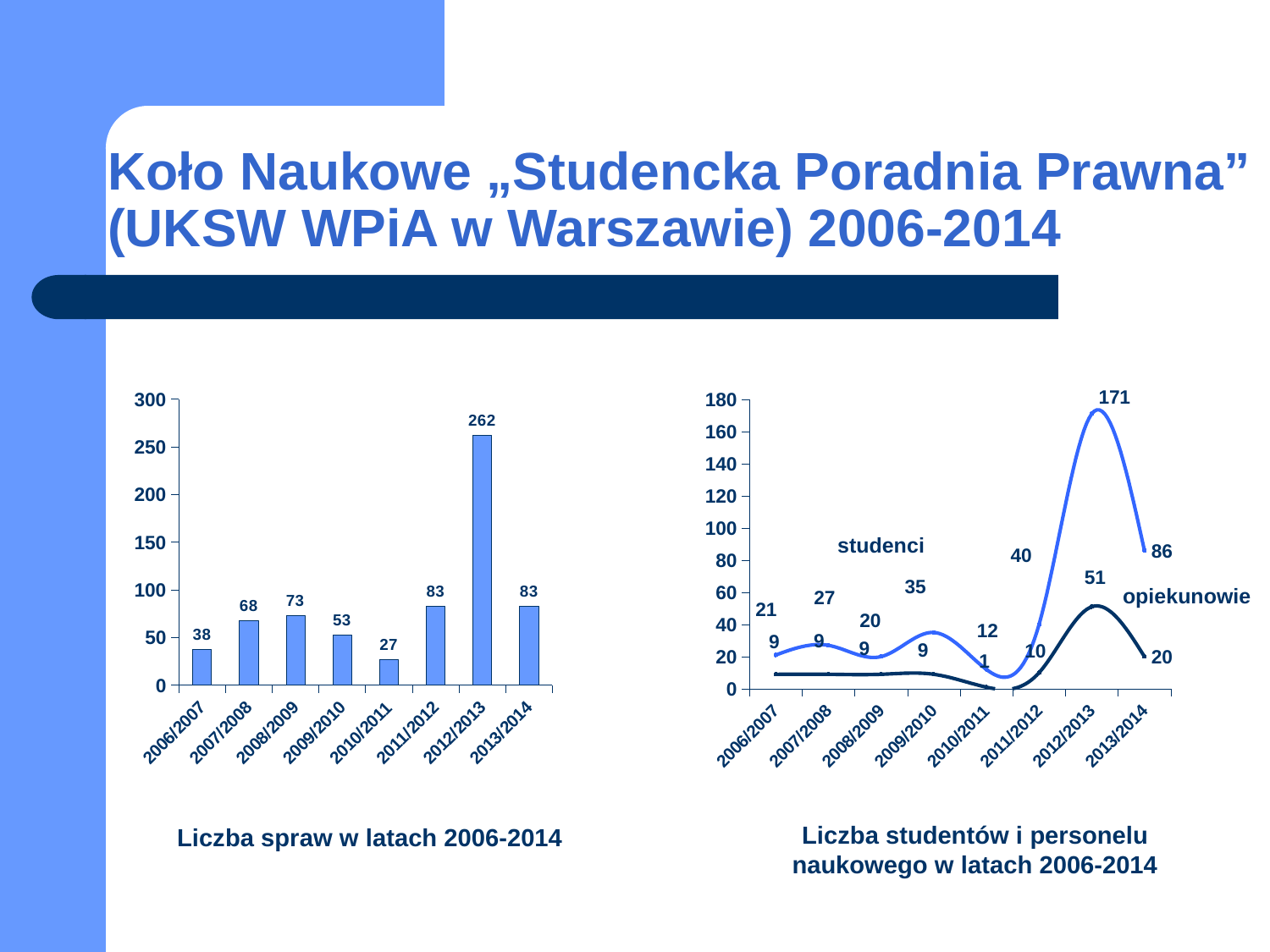
In the chart 'Liczba spraw w latach 2006-2014', what is the difference between the values for 2012/2013 and 2013/2014? 179 In the chart 'Liczba spraw w latach 2006-2014', which is larger, the value for 2007/2008 or 2009/2010? 2007/2008 In the chart 'Liczba studentów i personelu naukowego w latach 2006-2014', what is the value for opiekunowie in 2010/2011? 1 In the chart 'Liczba studentów i personelu naukowego w latach 2006-2014', what is the difference between studenci and opiekunowie in 2013/2014? 66 In the chart 'Liczba studentów i personelu naukowego w latach 2006-2014', what is the value for studenci in 2012/2013? 171 In the chart 'Liczba studentów i personelu naukowego w latach 2006-2014', what are the names of the two series labelled on the chart? studenci and opiekunowie What kind of chart is 'Liczba spraw w latach 2006-2014'? bar chart In the chart 'Liczba spraw w latach 2006-2014', what is the value for 2010/2011? 27 In the chart 'Liczba spraw w latach 2006-2014', how many years are shown on the x axis? 8 What kind of chart is 'Liczba studentów i personelu naukowego w latach 2006-2014'? line chart In the chart 'Liczba spraw w latach 2006-2014', what is the value for 2012/2013? 262 In the chart 'Liczba spraw w latach 2006-2014', which year has the lowest value? 2010/2011